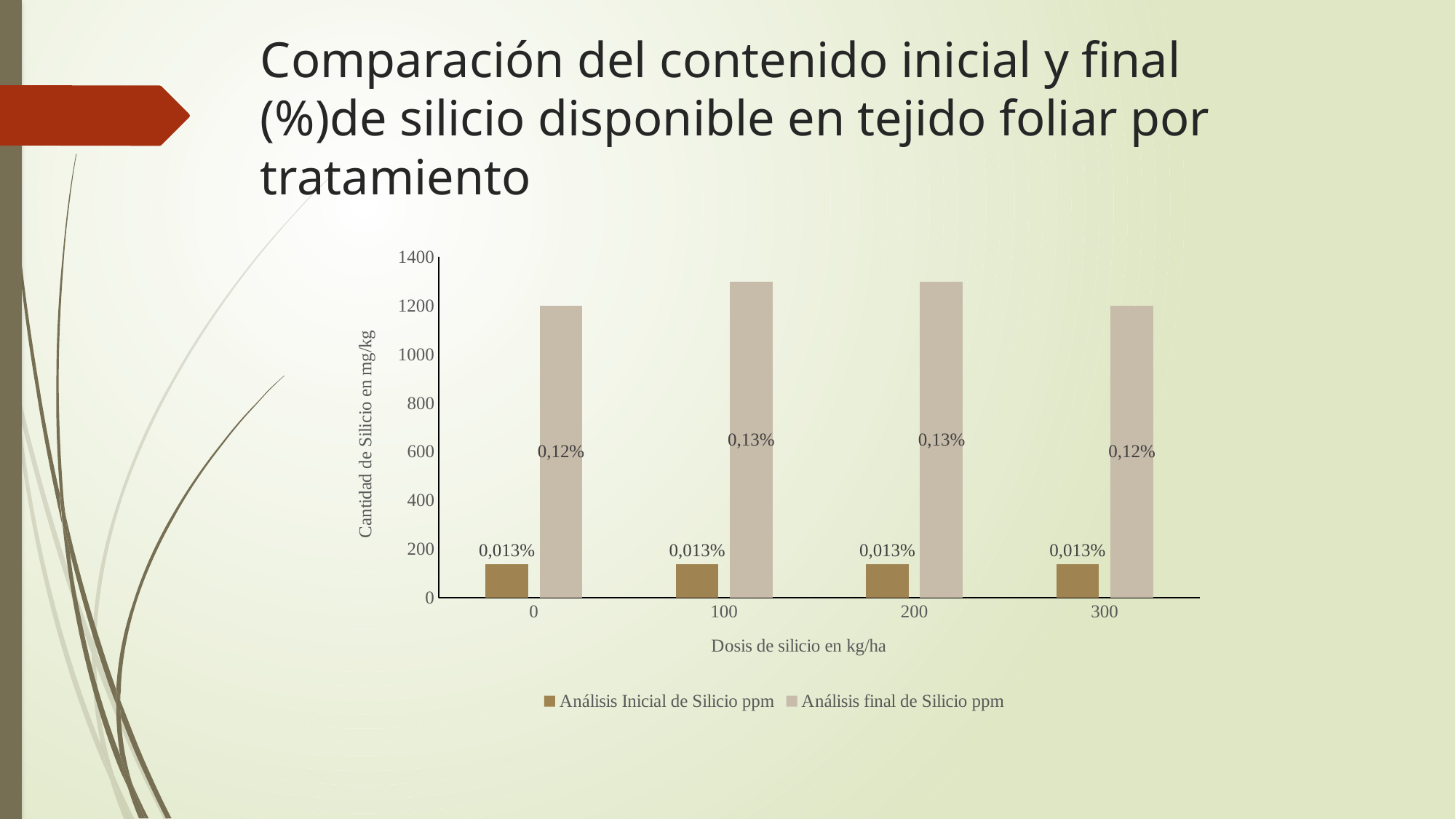
How many silicon dose categories are shown on the x axis? 4 Is the 'Análisis final de Silicio ppm' bar for the dose of 100 kg/ha greater or less than 1200? greater For the 'Análisis final de Silicio ppm' series, which dose has the taller bar: 100 kg/ha or 300 kg/ha? 100 kg/ha What is the data label on the 'Análisis Inicial de Silicio ppm' bar for the dose of 200 kg/ha? 0,013% How many series does the legend list? 2 What kind of chart is shown on the slide? bar chart Is the 'Análisis Inicial de Silicio ppm' bar for the dose of 0 kg/ha greater or less than 200? less At the dose of 100 kg/ha, which series has the taller bar? Análisis final de Silicio ppm What is the data label on the 'Análisis final de Silicio ppm' bar for the dose of 300 kg/ha? 0,12% What is the data label on the 'Análisis final de Silicio ppm' bar for the dose of 100 kg/ha? 0,13% What is the title of the x axis of the chart? Dosis de silicio en kg/ha Is the 'Análisis final de Silicio ppm' bar for the dose of 0 kg/ha greater or less than 1000? greater